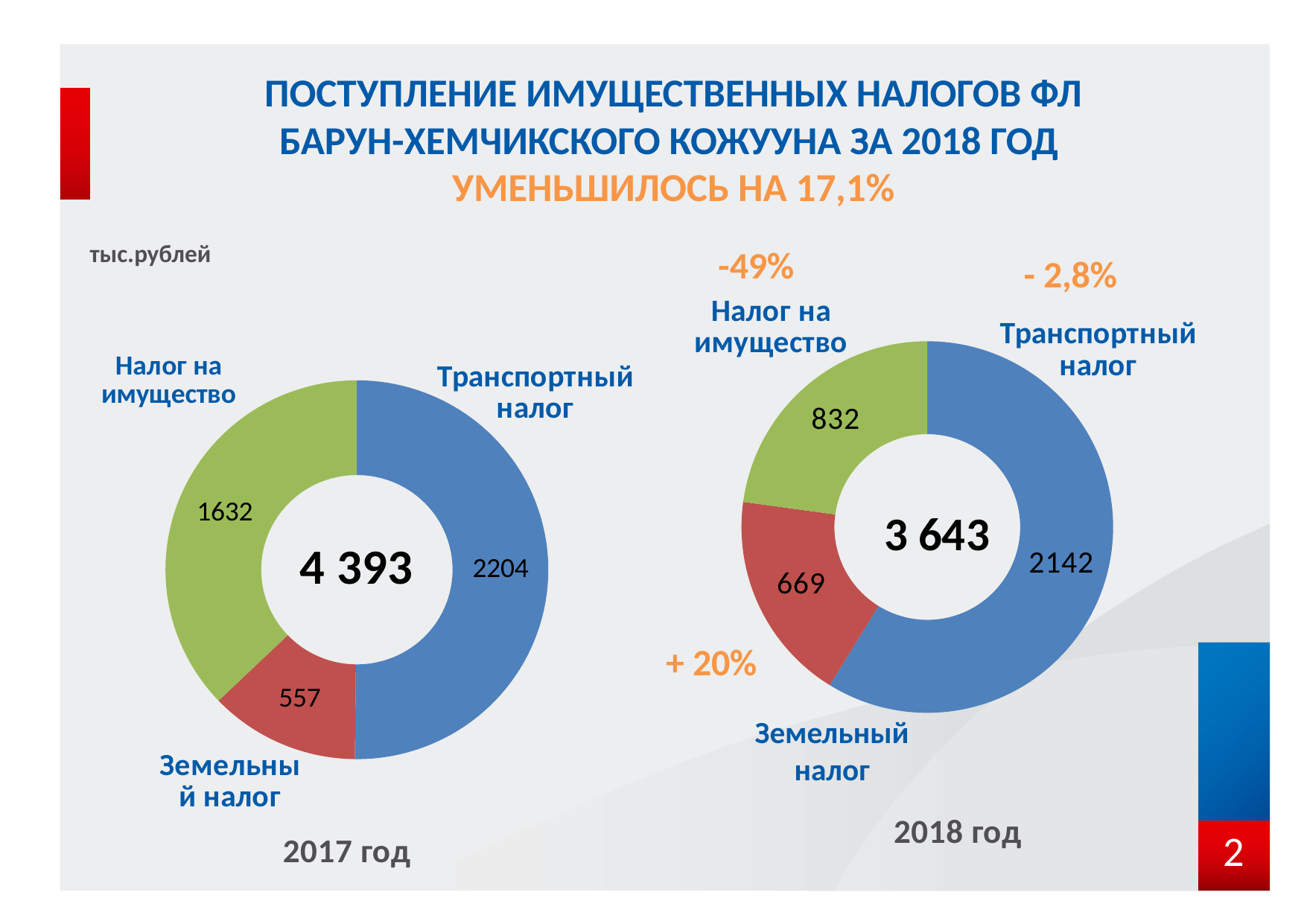
Is the value for Налог на имущество larger on the 2017 год chart or the 2018 год chart? 2017 год On the 2017 год chart, which category has the largest value? Транспортный налог On the 2017 год chart, which category has the smallest value? Земельный налог On the 2018 год chart, which category has the smallest value? Земельный налог On the 2018 год chart, what is the value for Налог на имущество? 832 On the 2018 год chart, what is the difference between Транспортный налог and Налог на имущество? 1310 How many categories does the 2017 год chart show? 3 On the 2018 год chart, what is the value for Земельный налог? 669 What type of chart is used on this slide? Donut (pie) chart On the 2017 год chart, what is the value for Транспортный налог? 2204 On the 2017 год chart, what is the difference between Транспортный налог and Налог на имущество? 572 What total is shown in the centre of the 2018 год chart? 3 643